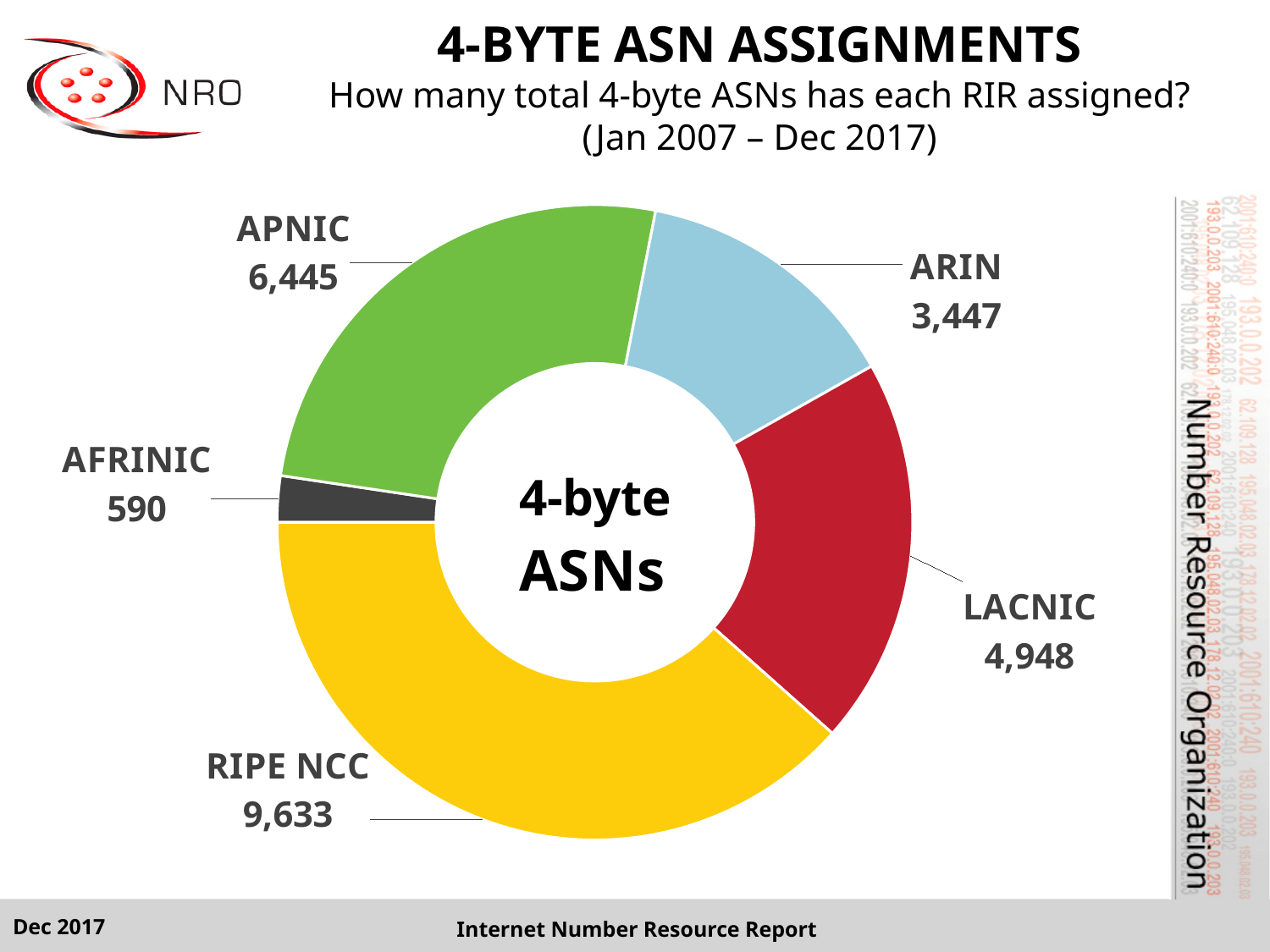
How many RIRs are shown as slices in the chart? 5 Which RIR has assigned the fewest 4-byte ASNs? AFRINIC What is the value shown for APNIC? 6,445 How many more 4-byte ASNs has RIPE NCC assigned than APNIC? 3,188 How many 4-byte ASNs has RIPE NCC assigned according to the chart? 9,633 What is the difference between the LACNIC and ARIN values? 1,501 What is the value shown for AFRINIC? 590 What kind of chart is shown on the slide? doughnut chart Which RIR has assigned the most 4-byte ASNs? RIPE NCC Which has assigned more 4-byte ASNs, ARIN or LACNIC? LACNIC What is the value shown for LACNIC? 4,948 What colour is the RIPE NCC slice? yellow